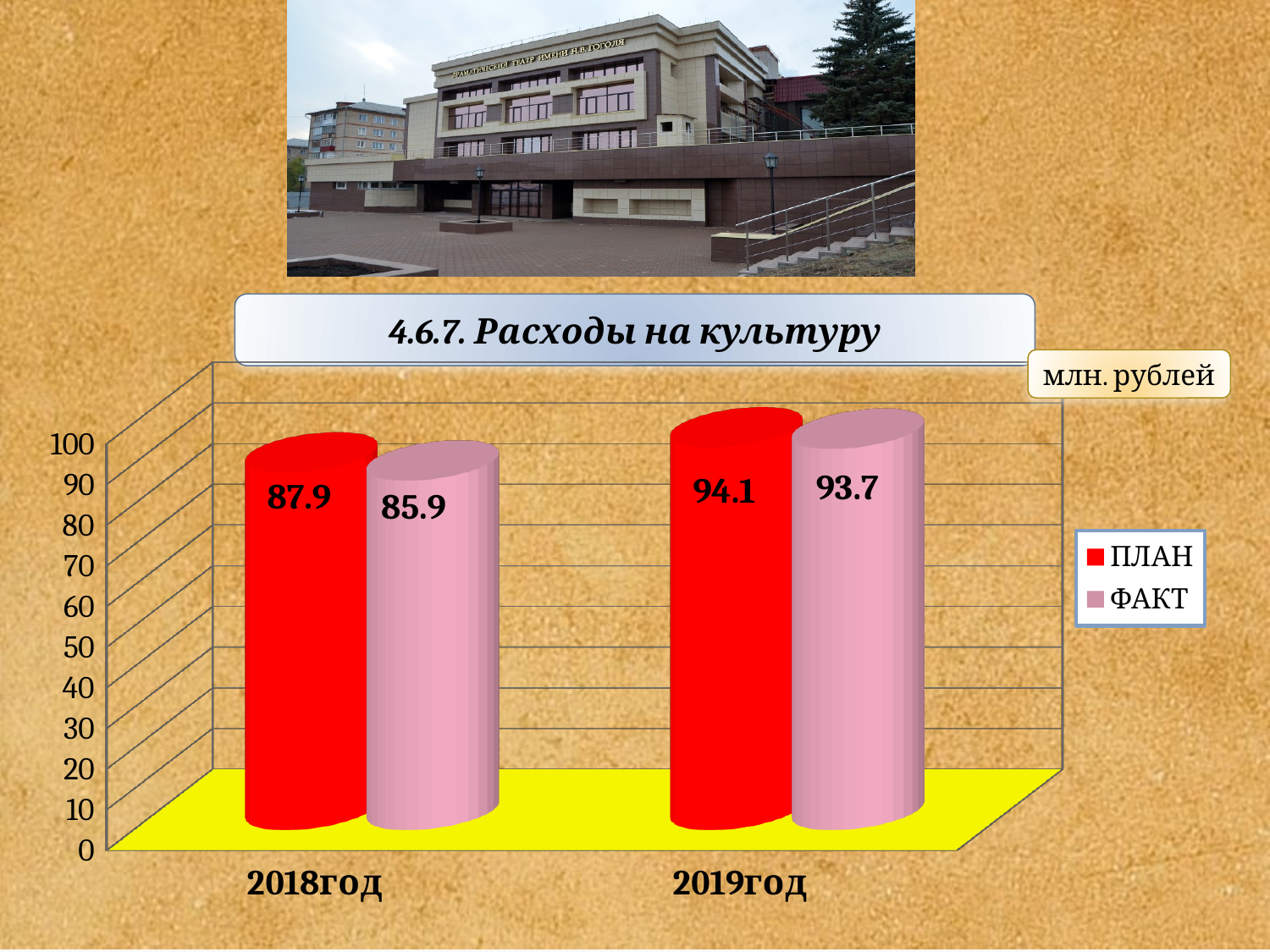
How many year categories are shown on the x axis? 2 What is the difference between the ПЛАН and ФАКТ values for 2018год? 2.0 How many series does the legend list? 2 What is the ФАКТ value for 2019год? 93.7 Which year has the lowest ФАКТ value? 2018год Which year has the highest ПЛАН value? 2019год What kind of chart is shown on the slide? bar chart Which is larger for 2019год, ПЛАН or ФАКТ? ПЛАН What is the difference between the ФАКТ values for 2019год and 2018год? 7.8 What is the ПЛАН value for 2018год? 87.9 What unit is indicated for the chart values? млн. рублей What is the ФАКТ value for 2018год? 85.9